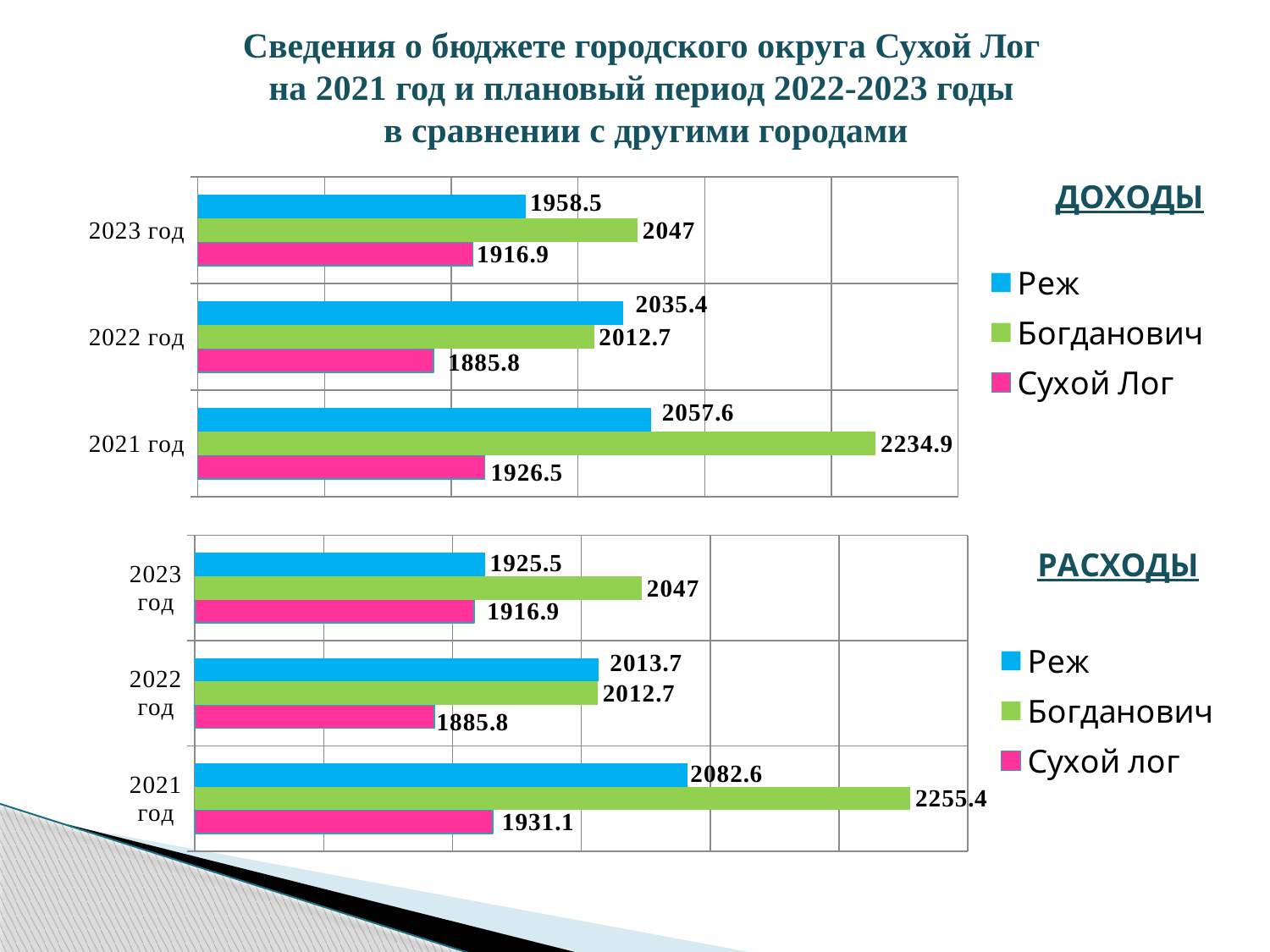
In the РАСХОДЫ chart, which city has the highest value in 2021 год? Богданович In the ДОХОДЫ chart, what is the value for Реж in 2023 год? 1958.5 In the ДОХОДЫ chart, which city has the lowest value in 2022 год? Сухой Лог In the ДОХОДЫ chart, how many series does the legend list? 3 In the РАСХОДЫ chart, what is the value for Сухой лог in 2021 год? 1931.1 In the ДОХОДЫ chart, what is the value for Богданович in 2021 год? 2234.9 In the РАСХОДЫ chart, how many year categories are shown? 3 In the ДОХОДЫ chart, which city has the highest value in 2021 год? Богданович What type of chart is the РАСХОДЫ chart? bar chart In the РАСХОДЫ chart, what is the value for Реж in 2022 год? 2013.7 In the ДОХОДЫ chart, what is the difference between Богданович and Сухой Лог in 2023 год? 130.1 In the РАСХОДЫ chart, is the value for Богданович in 2023 год larger or smaller than the value for Реж in 2023 год? larger